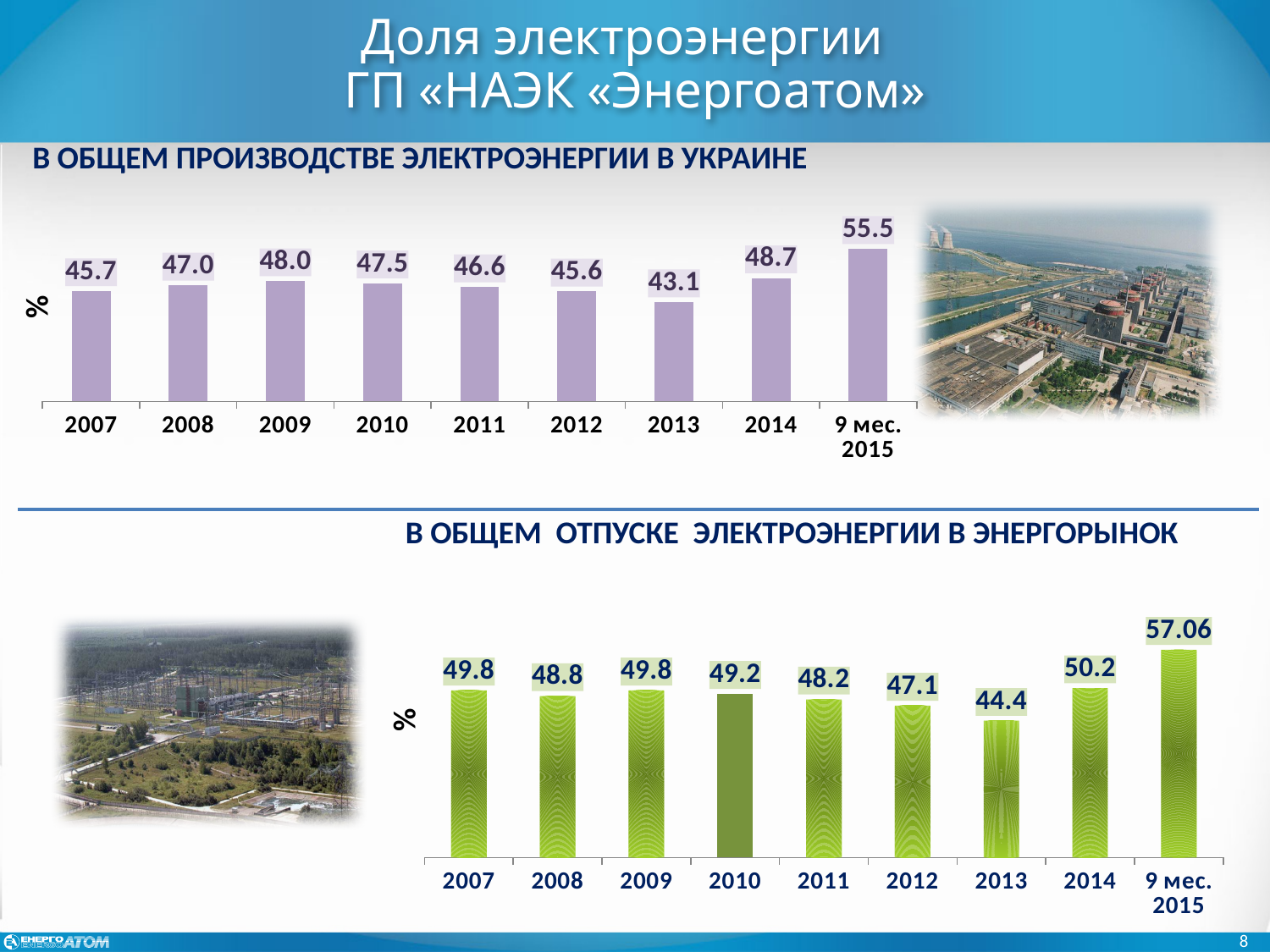
In the top chart (share in total electricity production in Ukraine), how many bars are plotted? 9 In the top chart (share in total electricity production in Ukraine), which period has the highest value? 9 мес. 2015 In the bottom chart (share in total electricity supply to the energy market), which year has the lowest value? 2013 In the bottom chart (share in total electricity supply to the energy market), what is the difference between the 2014 value and the 2011 value? 2.0 In the bottom chart, which year's bar is shown in a darker green than the others? 2010 In the top chart (share in total electricity production in Ukraine), what is the difference between the 2014 value and the 2013 value? 5.6 What type of chart is the top chart on the slide? Bar chart In the bottom chart (share in total electricity supply to the energy market), what is the value for 2013? 44.4 In the bottom chart (share in total electricity supply to the energy market), which is larger: the value for 2014 or the value for 2012? 2014 In the top chart (share in total electricity production in Ukraine), what is the value for 2009? 48.0 In the bottom chart (share in total electricity supply to the energy market), what is the value for 9 мес. 2015? 57.06 In the top chart (share in total electricity production in Ukraine), which year has the lowest value? 2013